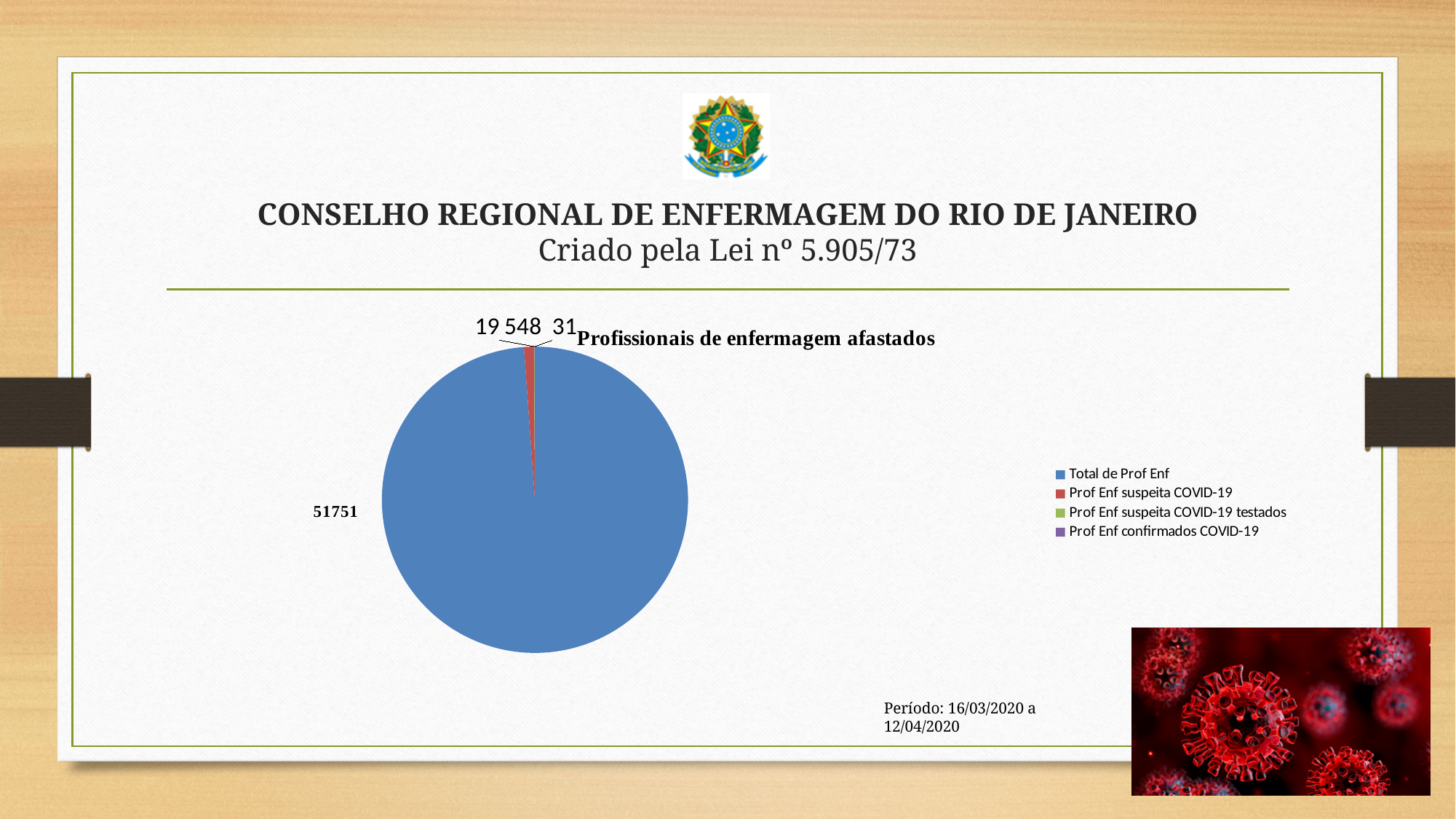
What is the title of the chart? Profissionais de enfermagem afastados Which is larger, Total de Prof Enf or Prof Enf suspeita COVID-19? Total de Prof Enf What is the smallest data label printed on the chart? 19 How many entries does the chart legend list? 4 What kind of chart is shown on the slide? pie chart What colour represents Prof Enf suspeita COVID-19 in the legend? red What is the value shown for Total de Prof Enf? 51751 Which category has the largest slice of the pie? Total de Prof Enf